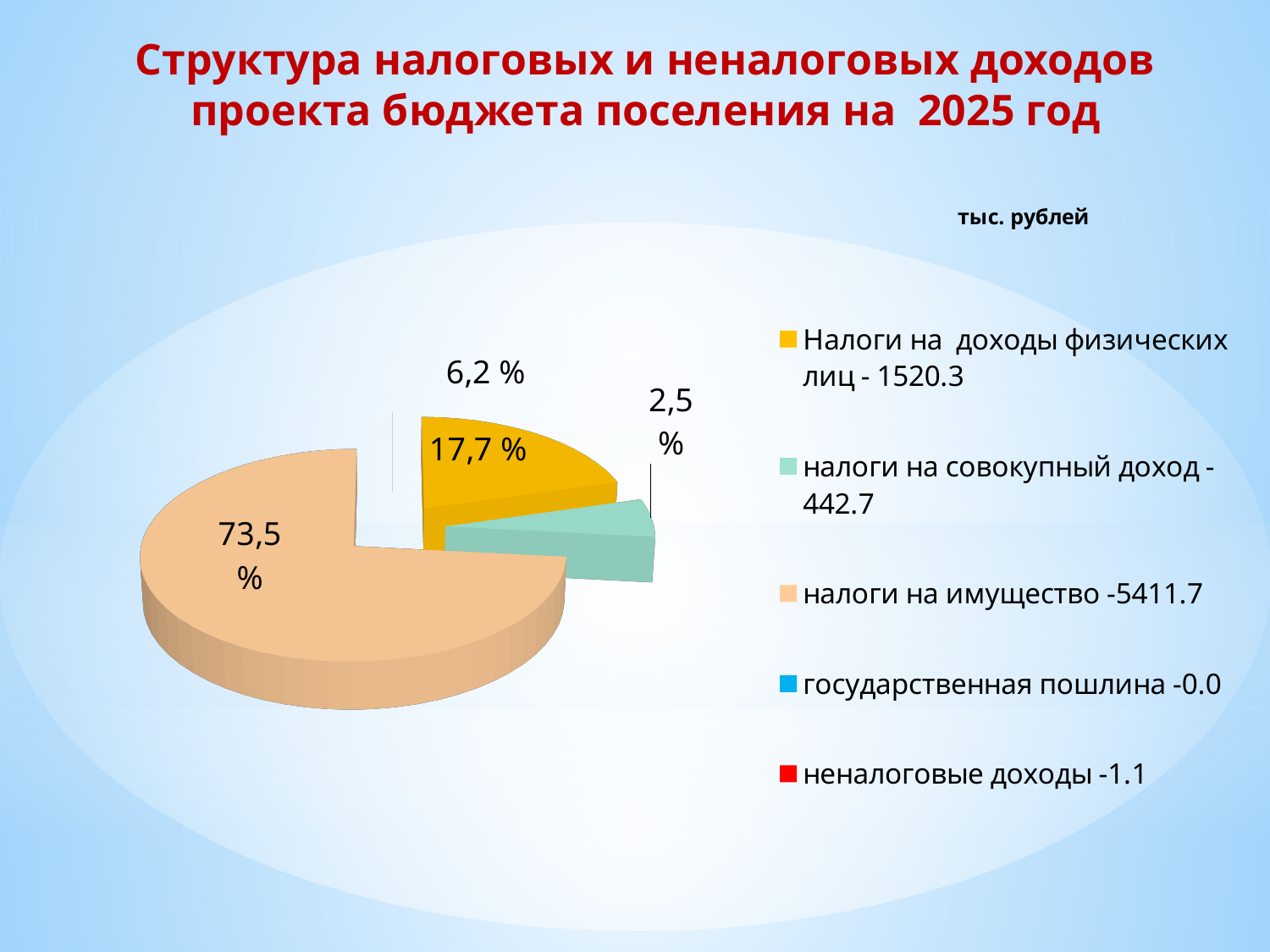
Which is larger according to the legend: Налоги на доходы физических лиц or налоги на совокупный доход? Налоги на доходы физических лиц What value is given in the legend for государственная пошлина? 0.0 What value is given in the legend for налоги на совокупный доход? 442.7 What value is given in the legend for неналоговые доходы? 1.1 How many entries does the legend of the pie chart list? 5 What is the difference between the legend values for Налоги на доходы физических лиц and налоги на совокупный доход? 1077.6 What value is given in the legend for Налоги на доходы физических лиц? 1520.3 What kind of chart is shown on the slide? Pie chart Which category has the largest slice of the pie? налоги на имущество What percentage label is shown on the yellow slice (Налоги на доходы физических лиц)? 17,7 % What percentage label is shown on the largest slice of the pie? 73,5 % What value is given in the legend for налоги на имущество? 5411.7